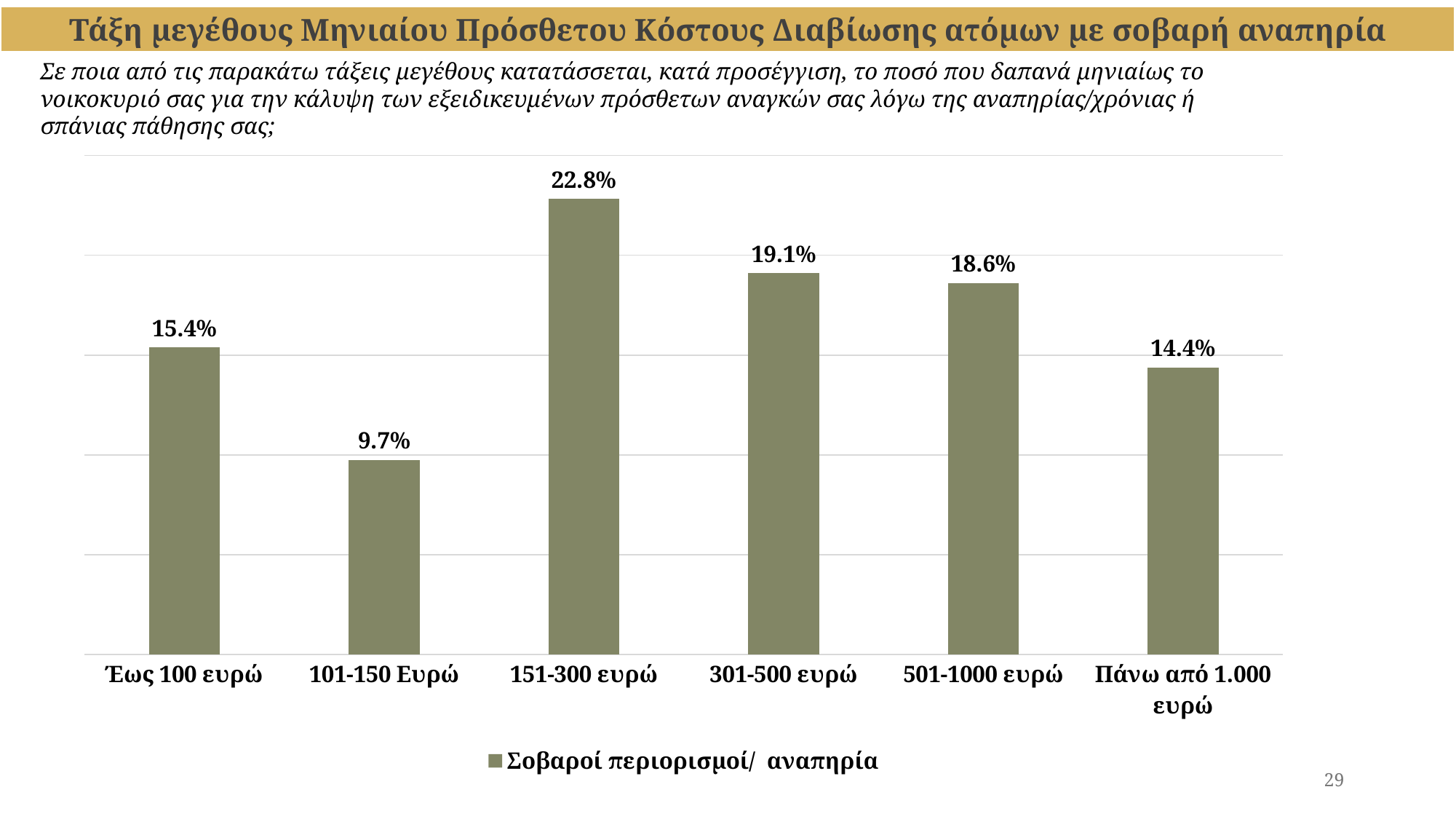
What is the value for the 'Πάνω από 1.000 ευρώ' category? 14.4% What is the difference between the values for '301-500 ευρώ' and '501-1000 ευρώ'? 0.5% What is the value for the '151-300 ευρώ' category? 22.8% Which category has the highest value? 151-300 ευρώ What is the legend entry for the series shown? Σοβαροί περιορισμοί/ αναπηρία What kind of chart is shown on the slide? Bar chart Which category has the lowest value? 101-150 Ευρώ Which is larger, the value for 'Έως 100 ευρώ' or the value for 'Πάνω από 1.000 ευρώ'? Έως 100 ευρώ What is the value for the 'Έως 100 ευρώ' category? 15.4% What is the difference between the values for '151-300 ευρώ' and '101-150 Ευρώ'? 13.1% How many categories are shown on the x axis? 6 How many series does the legend list? 1